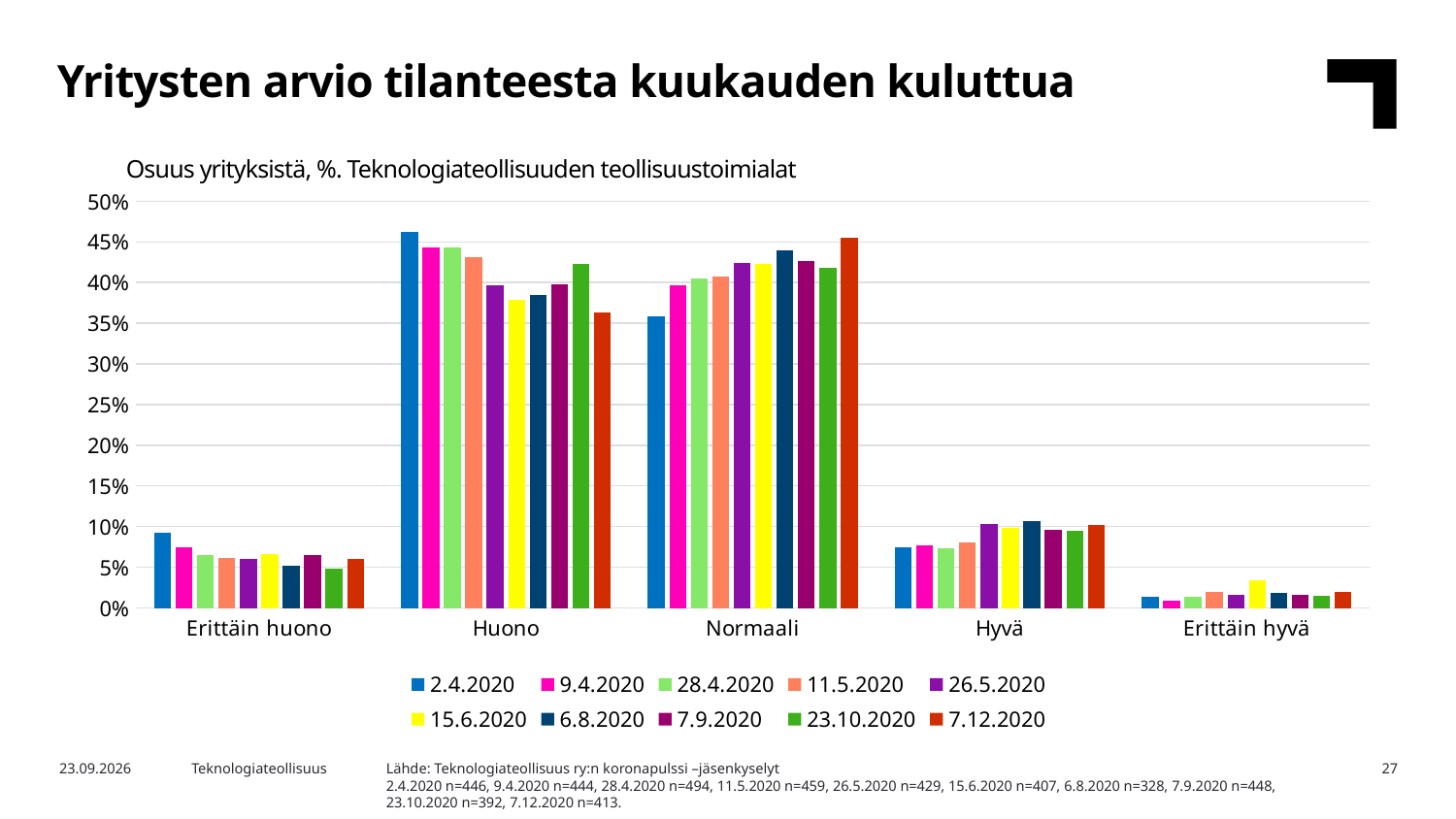
What is the title of the chart? Yritysten arvio tilanteesta kuukauden kuluttua Is the value for Huono on 2.4.2020 greater or less than 45%? greater For 2.4.2020, which is larger: the value for Huono or the value for Normaali? Huono Within the Erittäin hyvä category, which survey date has the highest value? 15.6.2020 Within the Normaali category, which survey date has the lowest value? 2.4.2020 Within the Huono category, which survey date has the highest value? 2.4.2020 Within the Huono category, which survey date has the lowest value? 7.12.2020 Is the value for Erittäin huono on 2.4.2020 greater or less than 10%? less Is the value for Erittäin hyvä on 15.6.2020 greater or less than 5%? less What kind of chart is shown on the slide? bar chart How many categories are shown on the x axis? 5 How many series does the legend list? 10